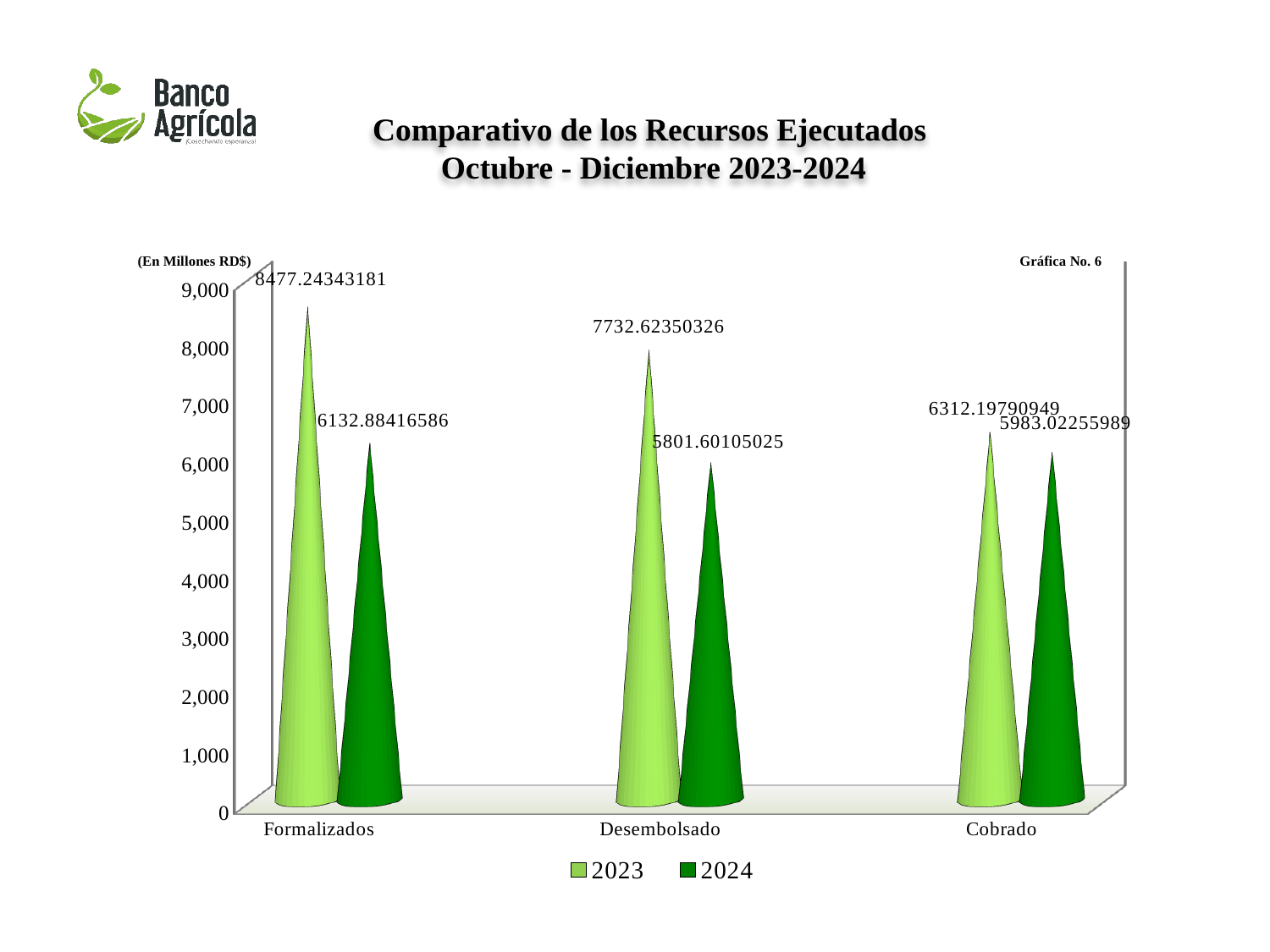
Which is larger for Cobrado, the 2023 value or the 2024 value? 2023 What is the title of the chart? Comparativo de los Recursos Ejecutados Octubre - Diciembre 2023-2024 What is the value for Cobrado in 2023? 6312.19790949 What is the value for Formalizados in 2023? 8477.24343181 How many categories are shown on the x axis? 3 What is the difference between the 2023 and 2024 values for Formalizados? 2344.35926595 What is the difference between the 2023 and 2024 values for Desembolsado? 1931.02245301 What is the value for Desembolsado in 2024? 5801.60105025 Which category has the highest value for 2023? Formalizados Which category has the lowest value for 2024? Desembolsado What is the value for Cobrado in 2024? 5983.02255989 How many series does the legend list? 2